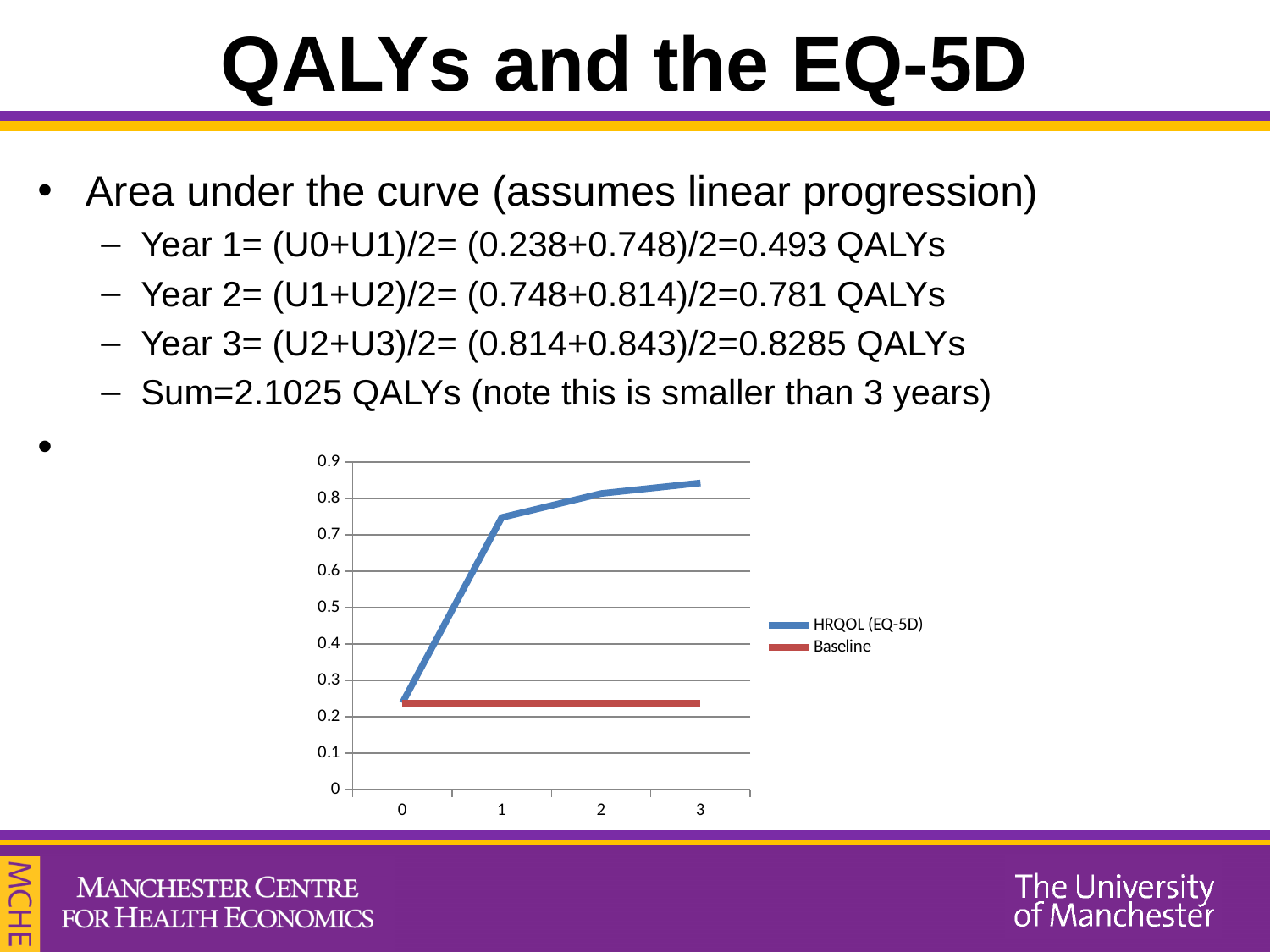
At which x-axis value is the HRQOL (EQ-5D) series lowest? 0 How many x-axis points are plotted for the HRQOL (EQ-5D) series? 4 How many series does the chart's legend list? 2 What kind of chart is shown on the slide? line chart Is the HRQOL (EQ-5D) value at x = 3 greater or less than 0.9? less Does the HRQOL (EQ-5D) line rise or fall as the x axis goes from 0 to 3? rise What colour is the Baseline line in the chart? red Is the HRQOL (EQ-5D) value at x = 1 greater or less than 0.7? greater At x = 2, which series has the larger value, HRQOL (EQ-5D) or Baseline? HRQOL (EQ-5D) Is the Baseline value at x = 2 greater or less than 0.3? less What are the two series named in the chart's legend? HRQOL (EQ-5D) and Baseline